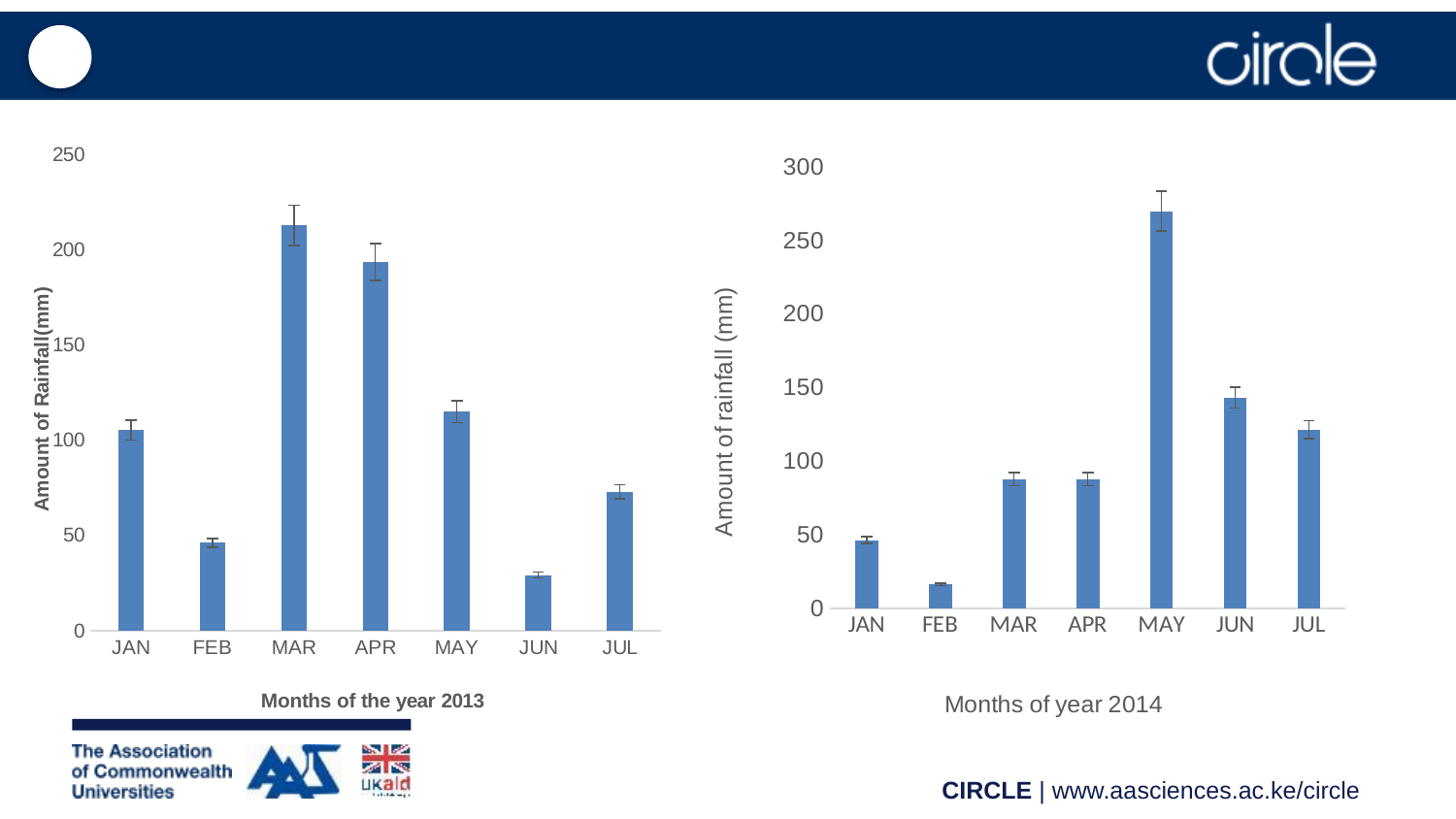
In the left chart (Months of the year 2013), which month has the lowest rainfall? JUN In the left chart (Months of the year 2013), which is larger, the value for JAN or the value for JUL? JAN How many months are shown on the x axis of the left chart (Months of the year 2013)? 7 In the right chart (Months of year 2014), is the value for MAY greater or less than 250? greater What kind of chart is the left chart (Months of the year 2013)? bar chart In the left chart (Months of the year 2013), which month has the highest rainfall? MAR What is the y-axis label of the right chart (Months of year 2014)? Amount of rainfall (mm) In the right chart (Months of year 2014), which month has the highest rainfall? MAY In the left chart (Months of the year 2013), is the value for FEB greater or less than 50? less In the left chart (Months of the year 2013), is the value for MAR greater or less than 200? greater In the right chart (Months of year 2014), which month has the lowest rainfall? FEB In the right chart (Months of year 2014), which is larger, the value for JUN or the value for JUL? JUN